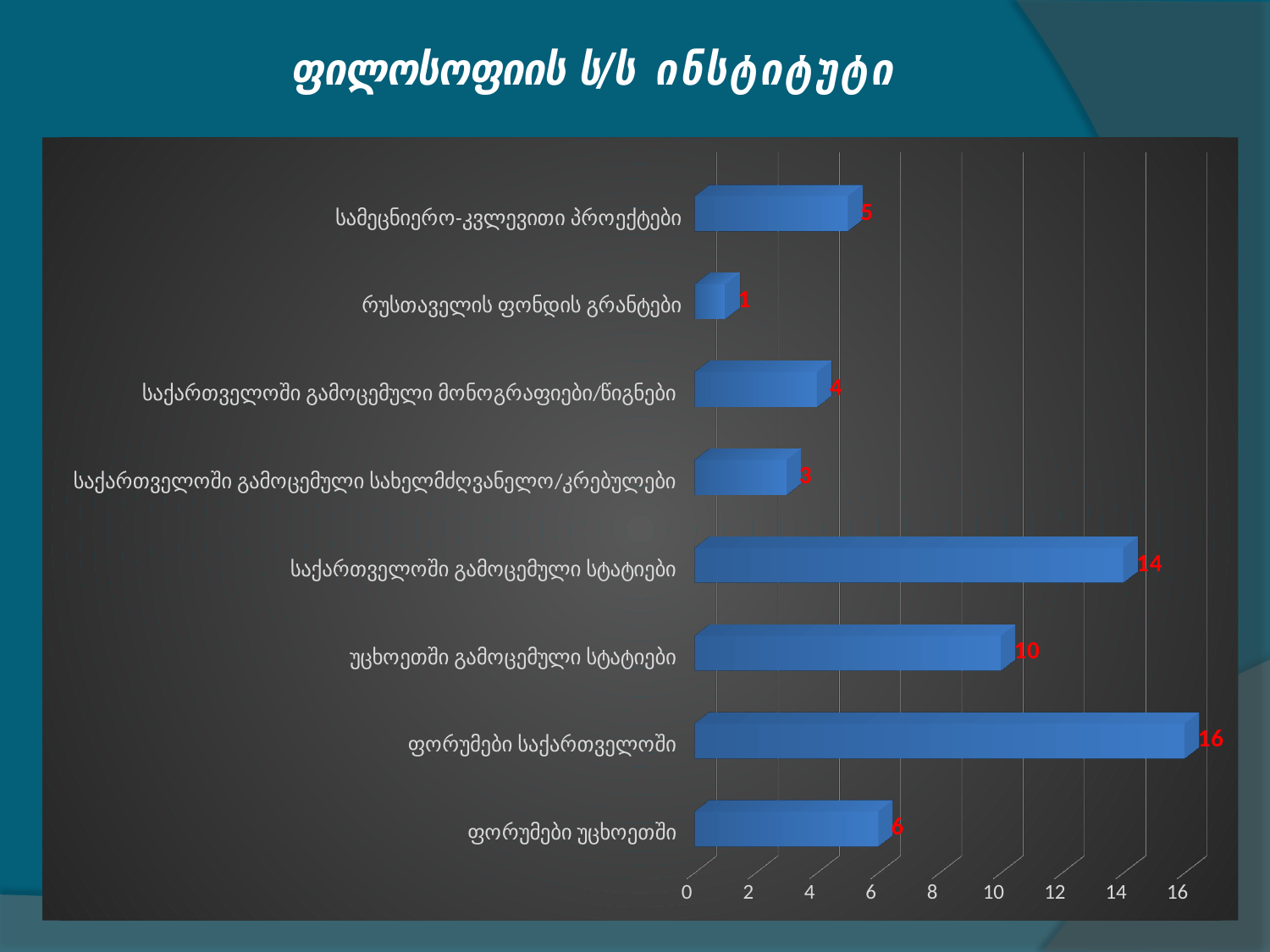
Which is larger: სამეცნიერო-კვლევითი პროექტები or საქართველოში გამოცემული მონოგრაფიები/წიგნები? სამეცნიერო-კვლევითი პროექტები What is the value for უცხოეთში გამოცემული სტატიები? 10 What kind of chart is shown on the slide? Bar chart What is the value for რუსთაველის ფონდის გრანტები? 1 What is the value for საქართველოში გამოცემული სტატიები? 14 Which category has the lowest value? რუსთაველის ფონდის გრანტები How many categories are shown in the chart? 8 What is the difference between ფორუმები საქართველოში and ფორუმები უცხოეთში? 10 What is the title of the slide? ფილოსოფიის ს/ს ინსტიტუტი What is the value for ფორუმები საქართველოში? 16 What is the difference between საქართველოში გამოცემული სტატიები and უცხოეთში გამოცემული სტატიები? 4 Which category has the highest value? ფორუმები საქართველოში